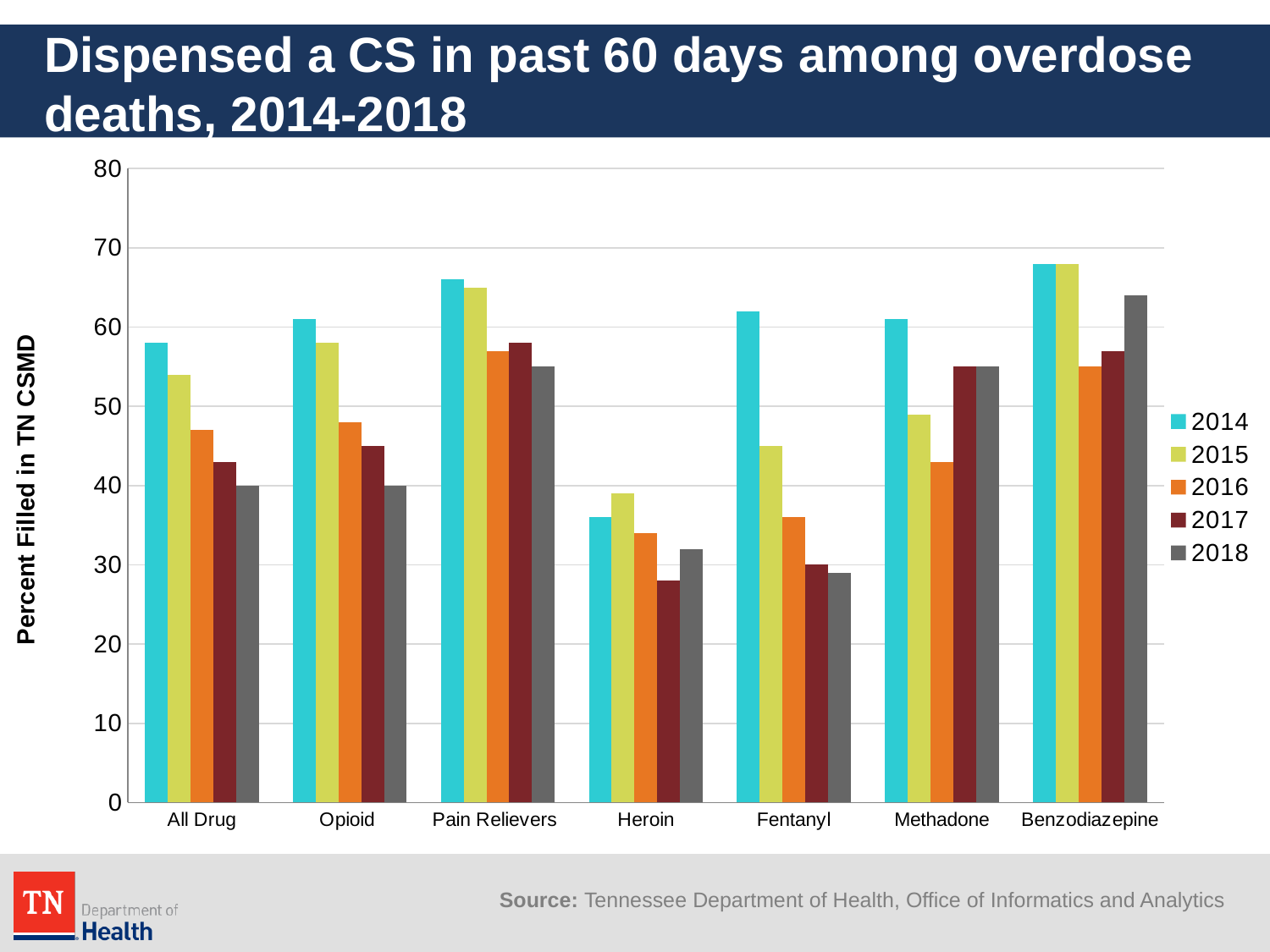
Which category has the lowest 2015 value? Heroin How many series does the legend list? 5 For Fentanyl, which is larger: the 2014 value or the 2018 value? 2014 How many drug categories are shown on the x axis? 7 For Fentanyl, do the values rise or fall from 2014 to 2018? fall What kind of chart is shown on the slide? bar chart Which category has the lowest 2014 value? Heroin For Methadone, which is larger: the 2016 value or the 2017 value? 2017 Is the 2017 value for Heroin greater or less than 30? less Is the 2014 value for Benzodiazepine greater or less than 60? greater Is the 2018 value for Pain Relievers greater or less than 50? greater What is the title of the y axis? Percent Filled in TN CSMD